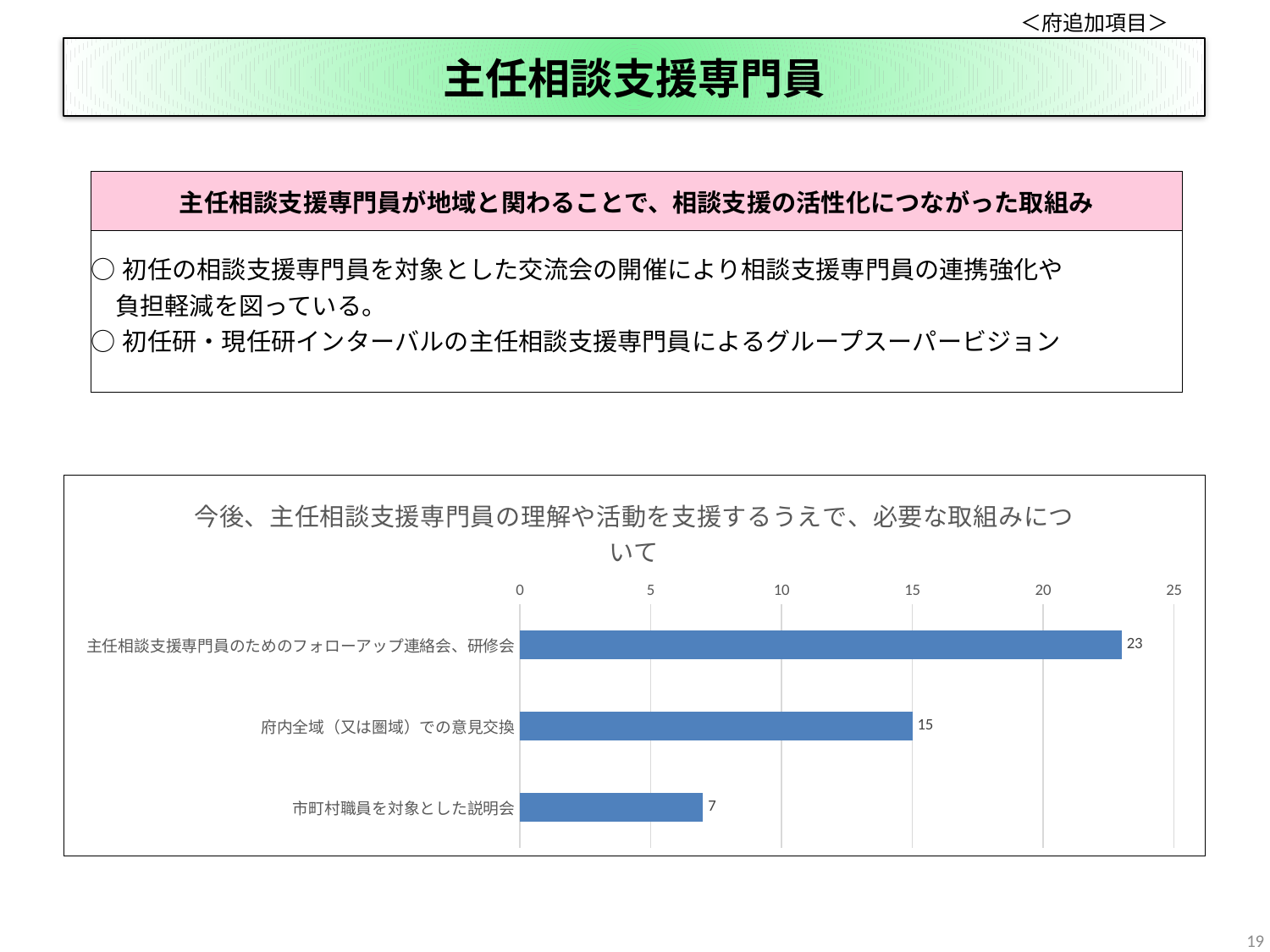
What is the difference between the values for 府内全域（又は圏域）での意見交換 and 市町村職員を対象とした説明会? 8 What kind of chart is shown on the slide? bar chart Is the value for 主任相談支援専門員のためのフォローアップ連絡会、研修会 greater or less than 20? greater Which category has the lowest value? 市町村職員を対象とした説明会 What is the value for 主任相談支援専門員のためのフォローアップ連絡会、研修会? 23 Which category has the highest value? 主任相談支援専門員のためのフォローアップ連絡会、研修会 How many categories are shown in the chart? 3 What is the value for 市町村職員を対象とした説明会? 7 What is the value for 府内全域（又は圏域）での意見交換? 15 What is the difference between the values for 主任相談支援専門員のためのフォローアップ連絡会、研修会 and 府内全域（又は圏域）での意見交換? 8 What is the title of the chart? 今後、主任相談支援専門員の理解や活動を支援するうえで、必要な取組みについて Which is larger, the value for 府内全域（又は圏域）での意見交換 or the value for 市町村職員を対象とした説明会? 府内全域（又は圏域）での意見交換